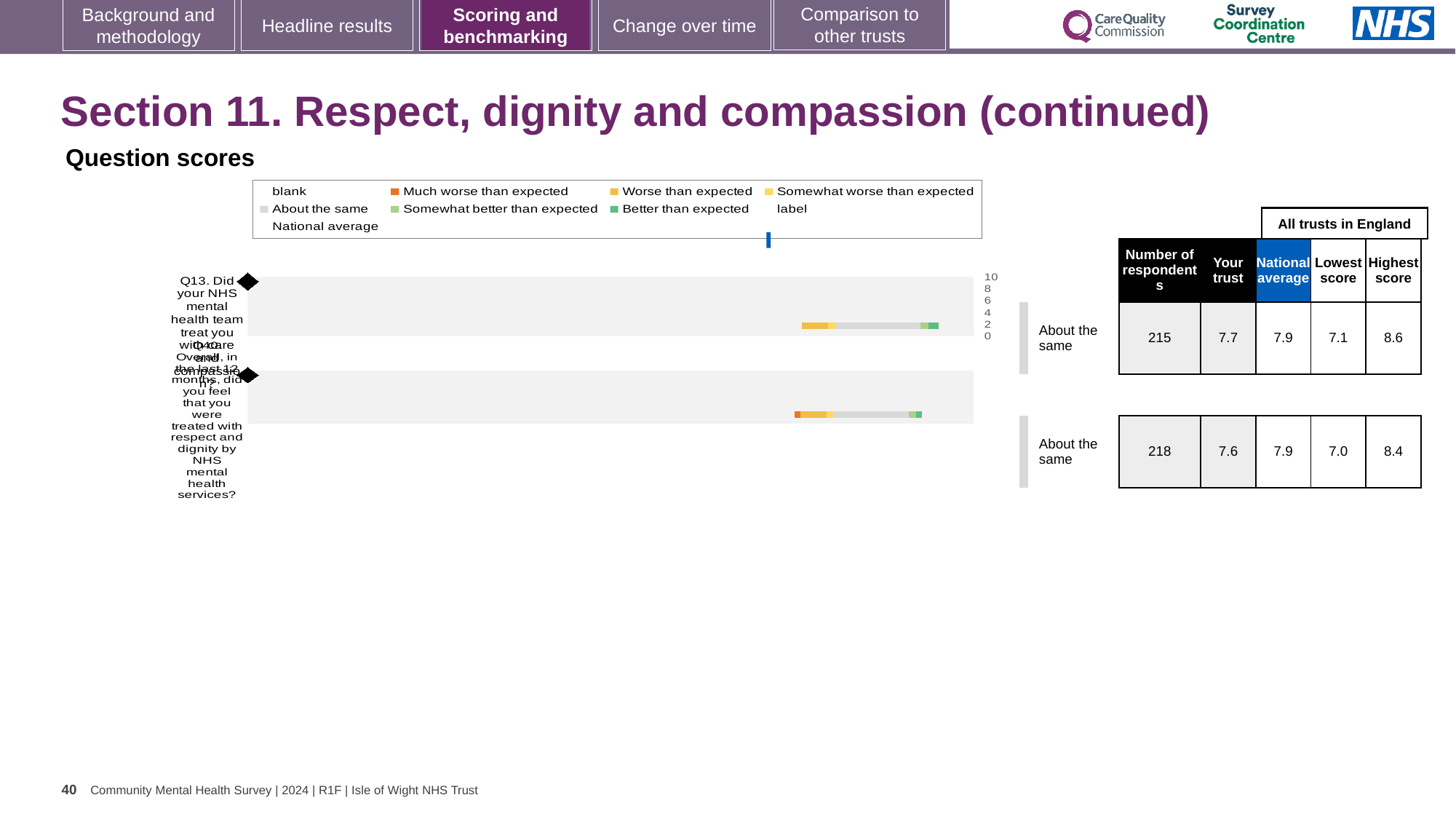
What is the national average score shown for Q13? 7.9 What is the highest score across all trusts in England for Q13? 8.6 How many questions are plotted in the question scores chart? 2 What is the 'Your trust' score for Q14 in the table next to the chart? 7.6 Which legend entry is shown in orange in the question scores chart? Much worse than expected What is the difference between the highest score and the lowest score for Q14? 1.4 What kind of chart is used to show the question scores on this slide? bar chart How many respondents are listed for Q14? 218 Which question has the higher 'Your trust' score, Q13 or Q14? Q13 What is the 'Your trust' score for Q13 in the table next to the chart? 7.7 What benchmark category is shown for both Q13 and Q14 next to the chart? About the same What is the lowest score across all trusts in England for Q14? 7.0